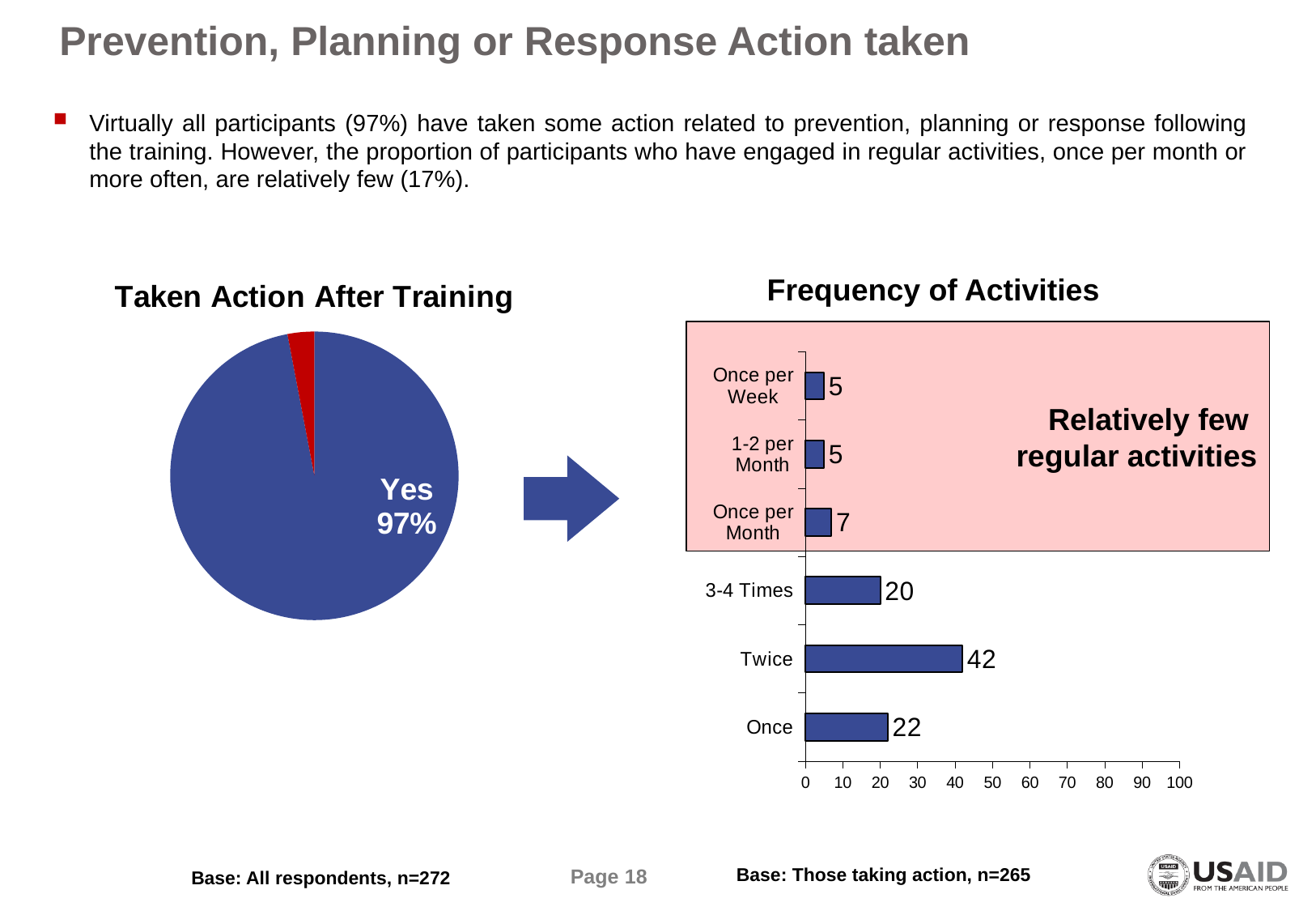
In the 'Frequency of Activities' chart, which category has the highest value? Twice In the 'Frequency of Activities' chart, what is the value for 3-4 Times? 20 In the 'Frequency of Activities' chart, which is larger, the value for 3-4 Times or the value for Once? Once In the 'Frequency of Activities' chart, what is the difference between the values for Twice and Once? 20 In the 'Frequency of Activities' chart, is the value for Twice greater or less than 40? greater How many categories are shown in the 'Frequency of Activities' chart? 6 In the 'Frequency of Activities' chart, what is the value for Once per Month? 7 What kind of chart is 'Taken Action After Training'? pie chart What kind of chart is 'Frequency of Activities'? bar chart In the 'Taken Action After Training' chart, what share of the pie is labelled Yes? 97% In the 'Frequency of Activities' chart, what is the value for Twice? 42 In the 'Frequency of Activities' chart, what is the total of the values for Once per Week, 1-2 per Month and Once per Month? 17